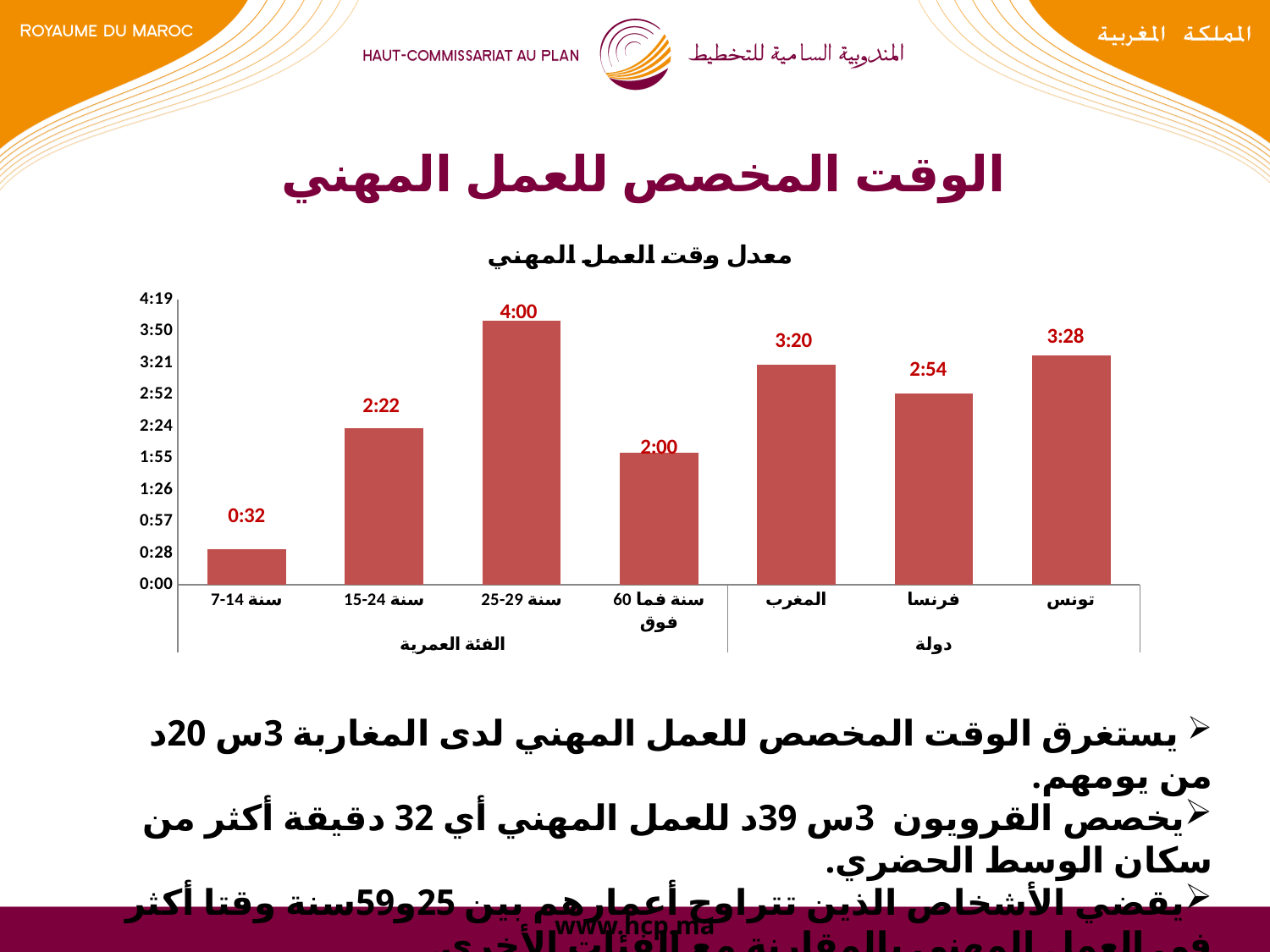
Is the value for 15-24 سنة greater or less than 2:52? less What is the value for the 7-14 سنة age group? 0:32 What is the title of the chart? معدل وقت العمل المهني How many bars are shown in the chart? 7 What is the difference between the values for تونس and فرنسا? 0:34 Which category has the highest value in the chart? 25-29 سنة Which category has the lowest value in the chart? 7-14 سنة Which is larger, the value for المغرب or the value for تونس? تونس What type of chart is shown on the slide? bar chart What is the value for المغرب in the chart? 3:20 What is the value for فرنسا? 2:54 What is the value for the 25-29 سنة age group? 4:00